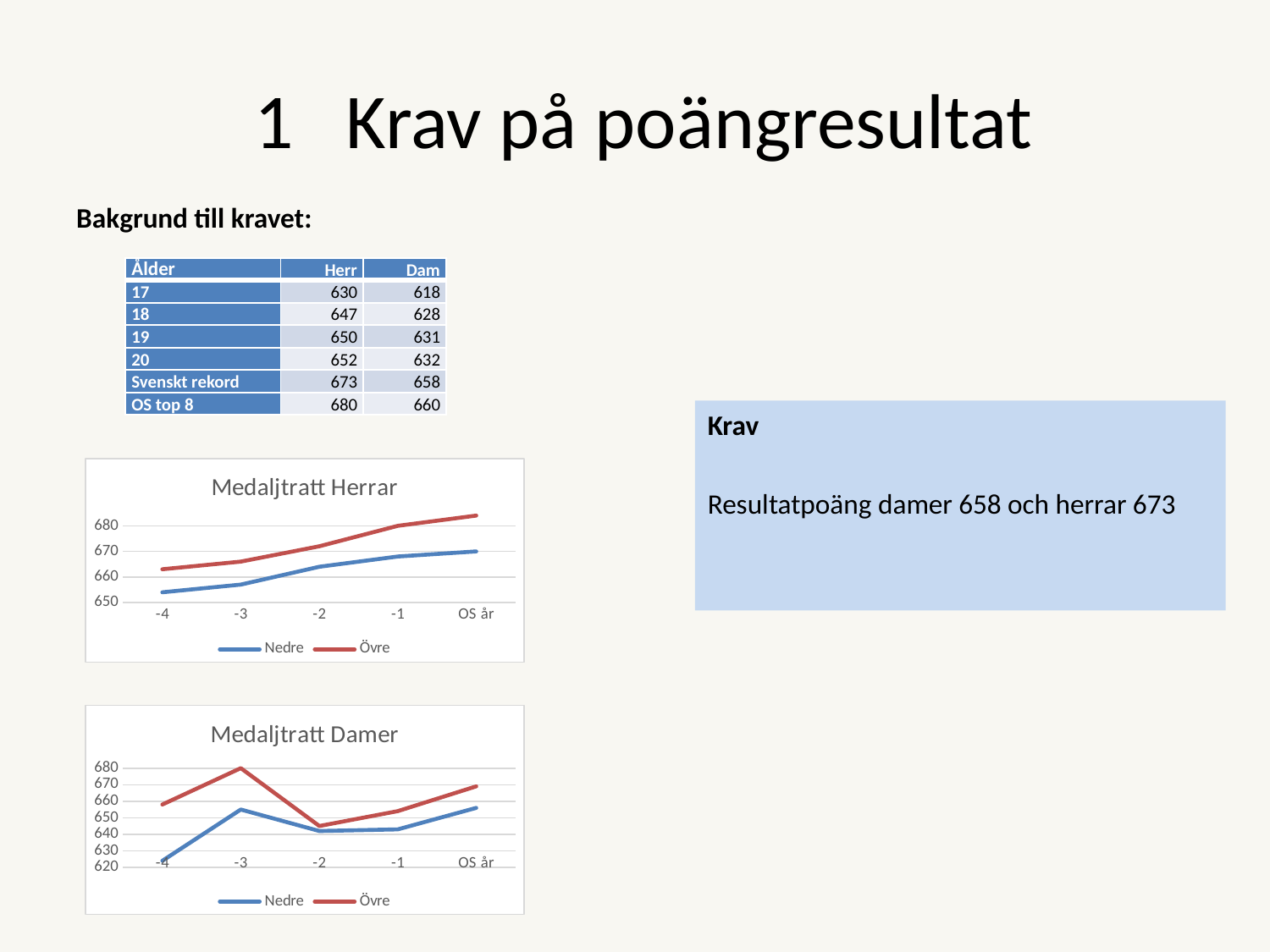
In "Medaljtratt Damer", at which x-axis point is the Övre series highest? -3 In "Medaljtratt Herrar", is the Övre value at OS år greater or less than 680? greater In "Medaljtratt Damer", is the Övre value at -2 greater or less than 650? less In "Medaljtratt Damer", which series has the larger value at -3, Nedre or Övre? Övre How many points are plotted along the x axis of "Medaljtratt Herrar"? 5 How many series does the legend of "Medaljtratt Damer" list? 2 What kind of chart is "Medaljtratt Herrar"? line chart In "Medaljtratt Herrar", is the Nedre value at -4 greater or less than 660? less What are the names of the two series in the legend of "Medaljtratt Herrar"? Nedre and Övre In "Medaljtratt Damer", at which x-axis point is the Nedre series lowest? -4 In "Medaljtratt Herrar", do the Övre values rise or fall from -4 to OS år? rise